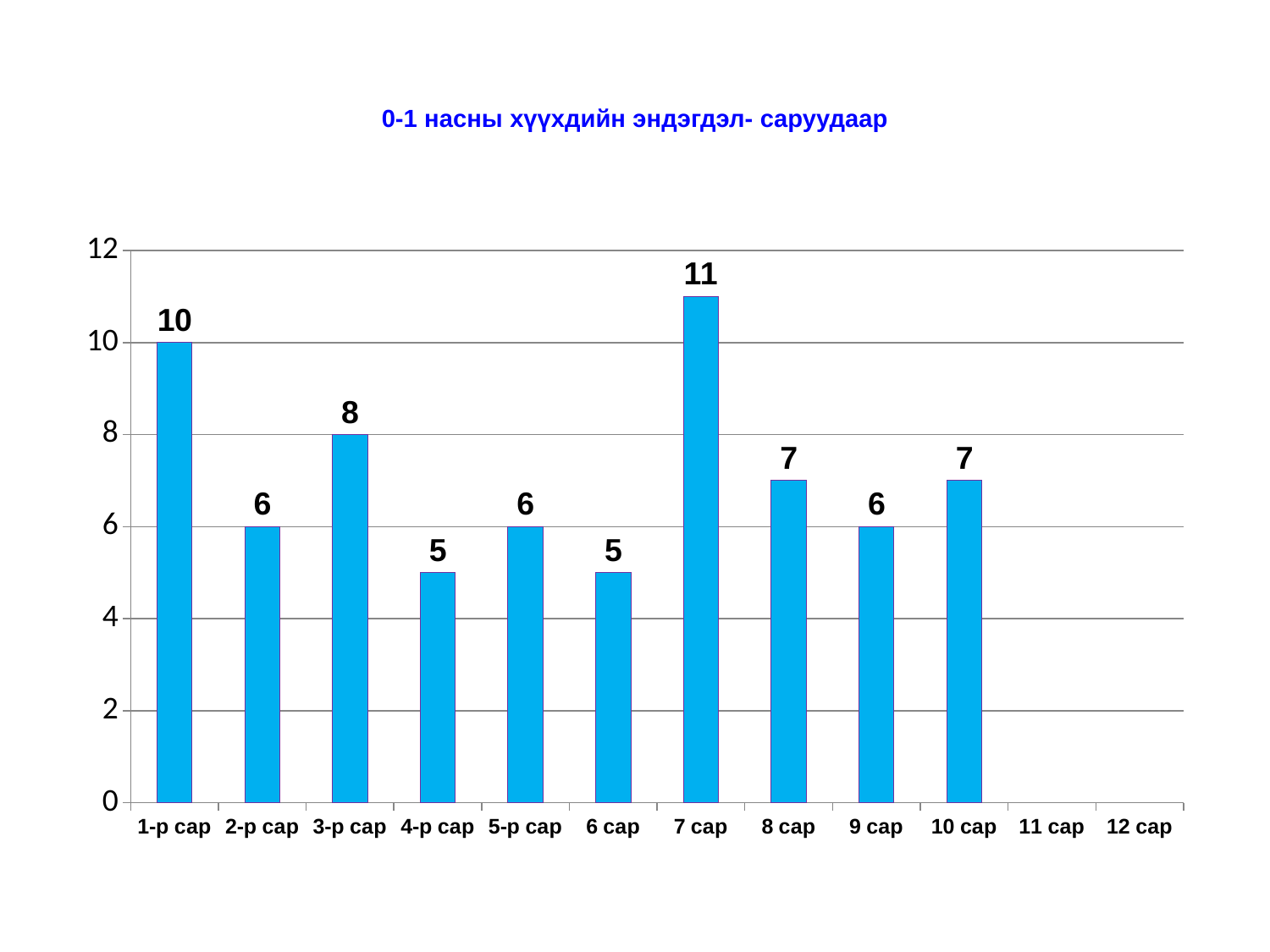
What is the difference between the values for 7 сар and 1-р сар? 1 Which month has the highest value? 7 сар What is the title of the chart? 0-1 насны хүүхдийн эндэгдэл- саруудаар What kind of chart is shown on the slide? Bar chart What is the value for 1-р сар? 10 Is the value for 1-р сар greater or less than 8? greater How many month categories are shown on the x axis? 12 Which is larger, the value for 8 сар or the value for 9 сар? 8 сар How many bars have a value of 6? 3 What is the difference between the values for 3-р сар and 4-р сар? 3 What is the value for 7 сар? 11 What is the value for 3-р сар? 8